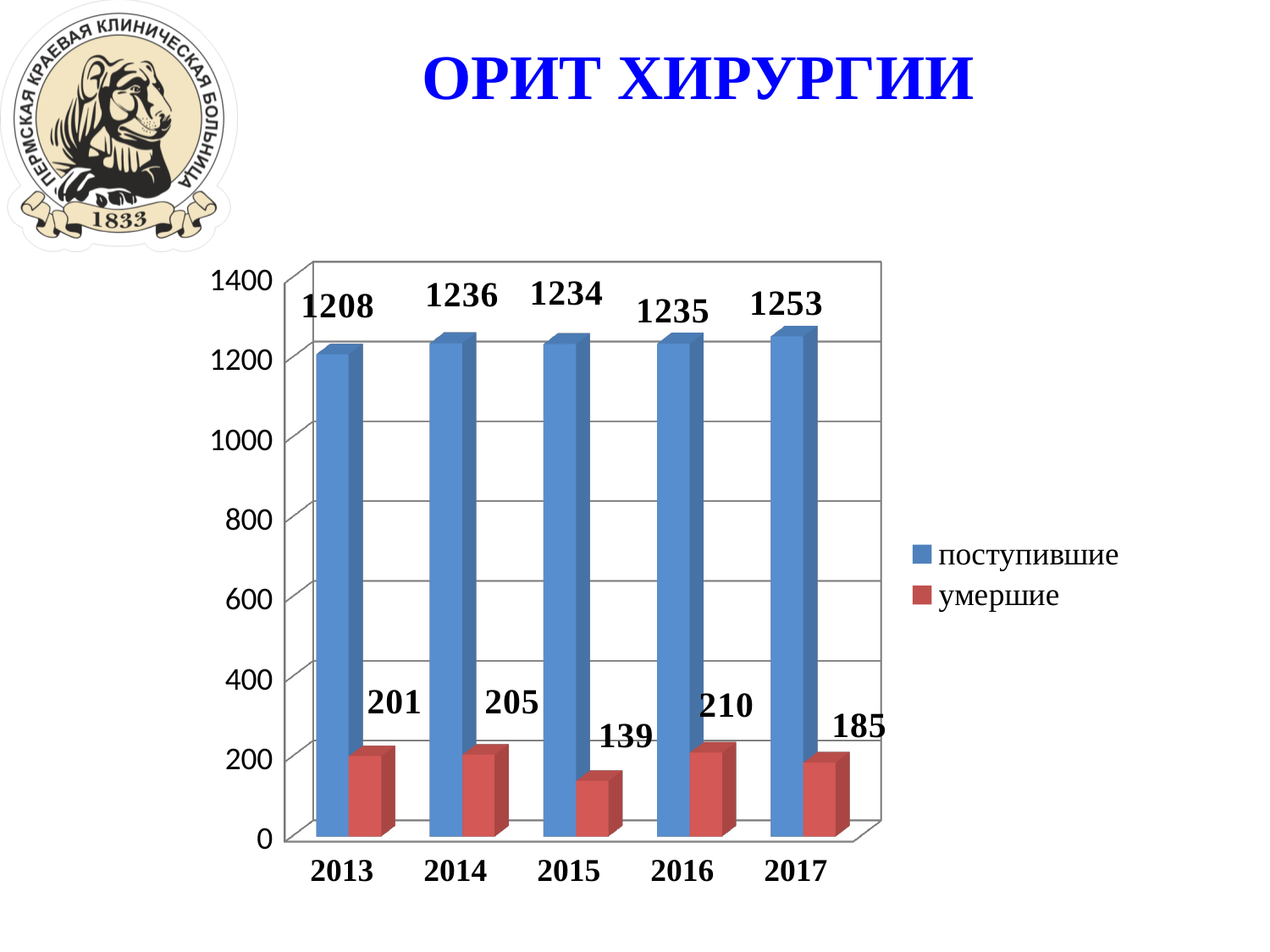
Which is larger, the умершие value for 2014 or for 2017? 2014 Which year has the highest value for умершие? 2016 What is the value for поступившие in 2017? 1253 Which year has the lowest value for поступившие? 2013 What is the difference between the поступившие values for 2017 and 2013? 45 How many years are shown on the x axis? 5 What kind of chart is shown on the slide? bar chart How many series does the legend list? 2 What is the value for умершие in 2015? 139 Which year has the lowest value for умершие? 2015 What is the value for поступившие in 2013? 1208 What is the difference between the умершие values for 2016 and 2015? 71